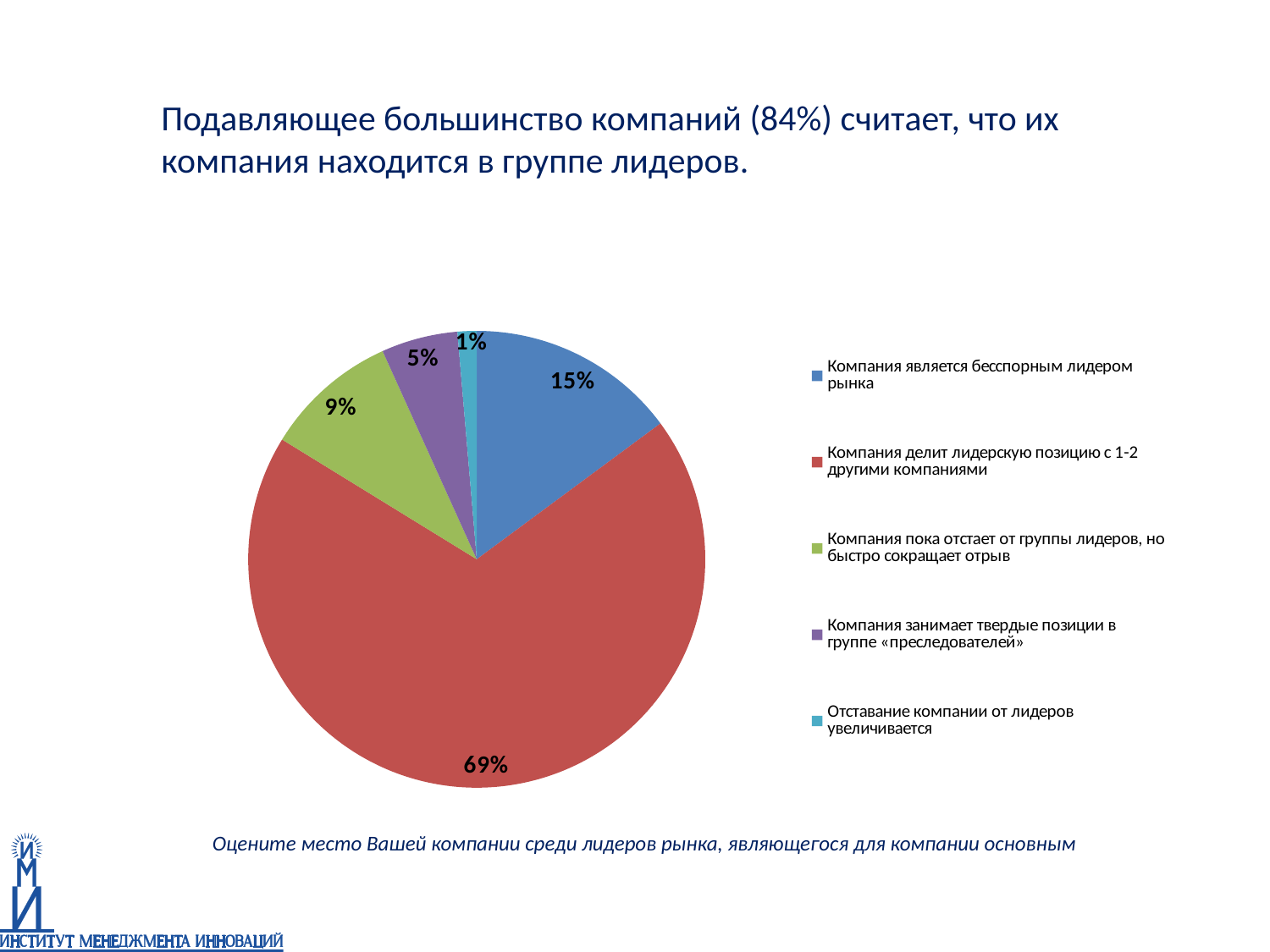
What share of the pie is labelled "Отставание компании от лидеров увеличивается"? 1% What share of the pie is labelled "Компания пока отстает от группы лидеров, но быстро сокращает отрыв"? 9% Which is larger: the slice for "Компания пока отстает от группы лидеров, но быстро сокращает отрыв" or the slice for "Компания занимает твердые позиции в группе «преследователей»"? Компания пока отстает от группы лидеров, но быстро сокращает отрыв What type of chart is shown on the slide? pie chart How many slices does the pie chart have? 5 What share of the pie is labelled "Компания является бесспорным лидером рынка"? 15% Which category has the largest slice of the pie? Компания делит лидерскую позицию с 1-2 другими компаниями Which category has the smallest slice of the pie? Отставание компании от лидеров увеличивается How many entries does the legend of the pie chart list? 5 What colour is the slice for "Компания занимает твердые позиции в группе «преследователей»"? purple What is the difference in percentage points between the slice for "Компания делит лидерскую позицию с 1-2 другими компаниями" and the slice for "Компания является бесспорным лидером рынка"? 54